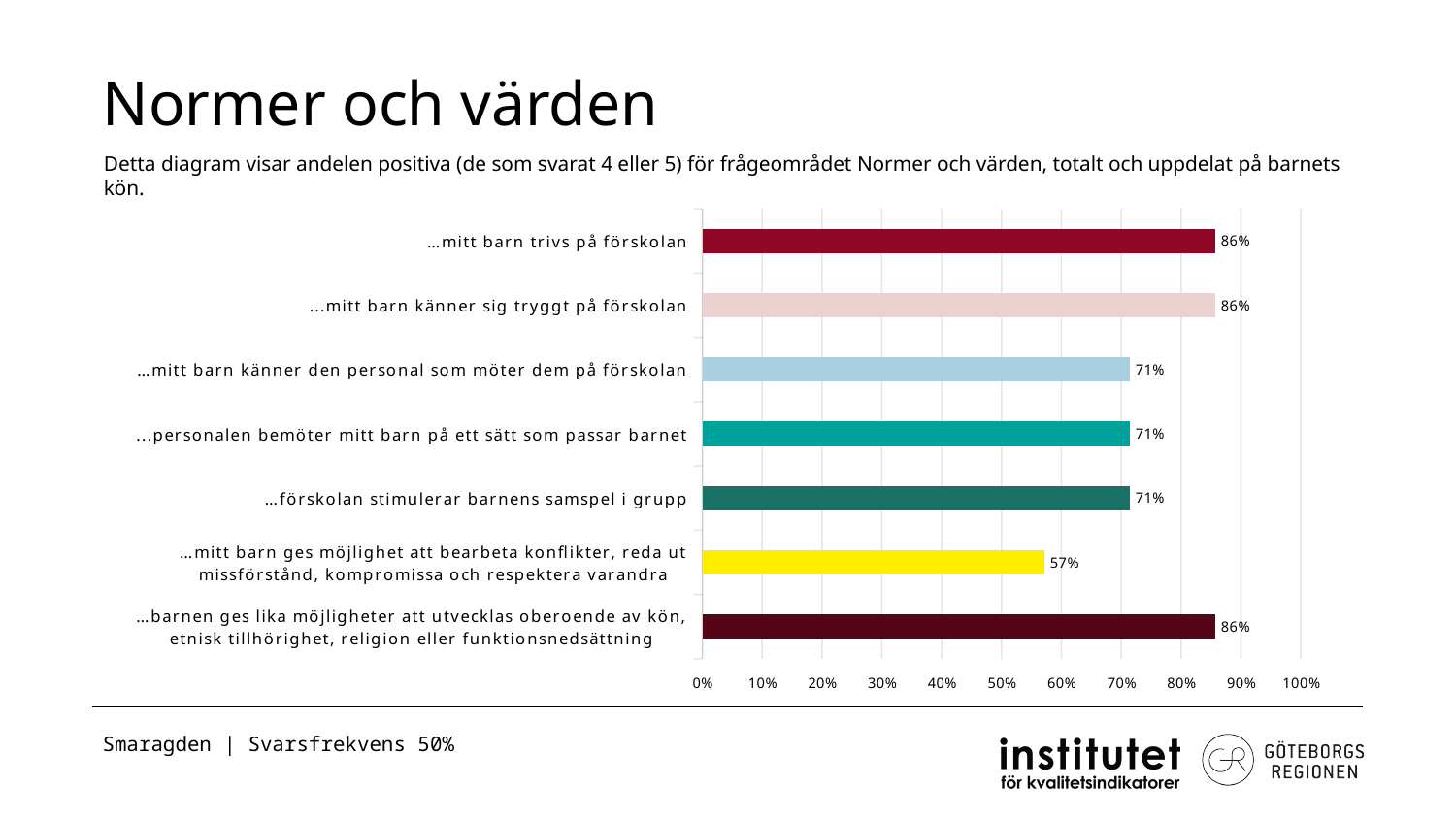
What kind of chart is shown on the slide? Bar chart What is the value for "…förskolan stimulerar barnens samspel i grupp"? 71% What is the value for "…mitt barn ges möjlighet att bearbeta konflikter, reda ut missförstånd, kompromissa och respektera varandra"? 57% How many categories (bars) does the chart show? 7 What is the value for "…barnen ges lika möjligheter att utvecklas oberoende av kön, etnisk tillhörighet, religion eller funktionsnedsättning"? 86% What is the difference between the value for "…mitt barn trivs på förskolan" and the value for "…mitt barn ges möjlighet att bearbeta konflikter, reda ut missförstånd, kompromissa och respektera varandra"? 29 percentage points Is the value for "...personalen bemöter mitt barn på ett sätt som passar barnet" greater or less than 60%? greater What is the value for "…mitt barn trivs på förskolan"? 86% What is the title of the slide containing the chart? Normer och värden What is the difference between the value for "...mitt barn känner sig tryggt på förskolan" and the value for "…mitt barn känner den personal som möter dem på förskolan"? 15 percentage points Which category has the lowest value? …mitt barn ges möjlighet att bearbeta konflikter, reda ut missförstånd, kompromissa och respektera varandra Which is larger: the value for "…mitt barn trivs på förskolan" or the value for "…förskolan stimulerar barnens samspel i grupp"? …mitt barn trivs på förskolan